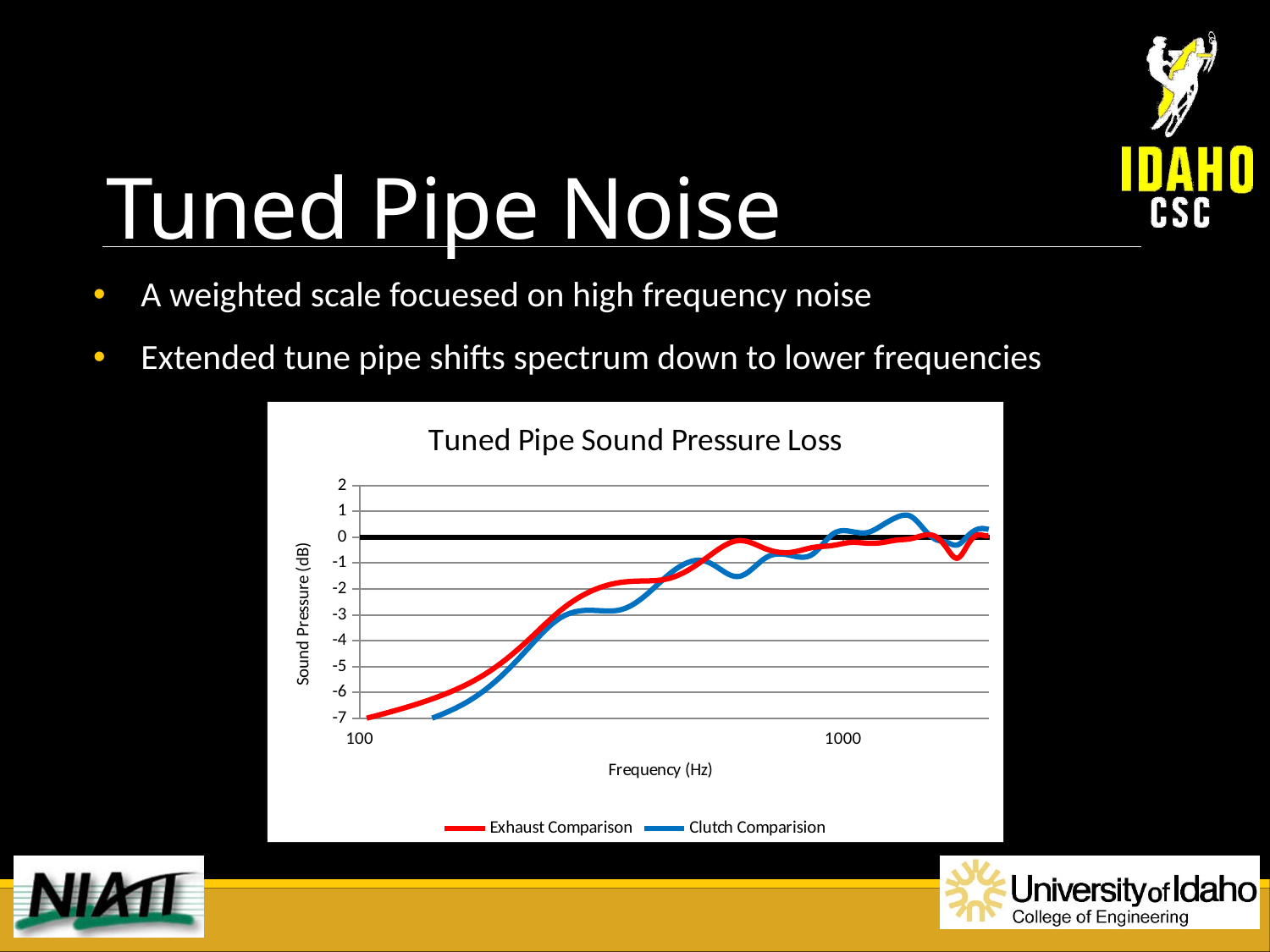
Is the value of the Exhaust Comparison series at 100 Hz greater or less than -5? less Is the value of the Exhaust Comparison series at 1000 Hz greater or less than -3? greater Is the lowest value of the Clutch Comparision series greater or less than -5? less What kind of chart is shown on the slide? line chart Overall, do the values of the Clutch Comparision series rise or fall as frequency increases from 100 Hz to 1000 Hz? rise How many series does the legend of the chart list? 2 Which series reaches the higher peak value on the chart, Exhaust Comparison or Clutch Comparision? Clutch Comparision Around 300 Hz, which series has the higher sound pressure value, Exhaust Comparison or Clutch Comparision? Exhaust Comparison What is the title of the chart? Tuned Pipe Sound Pressure Loss Overall, do the values of the Exhaust Comparison series rise or fall as frequency increases from 100 Hz to 1000 Hz? rise What is the label of the vertical axis of the chart? Sound Pressure (dB)